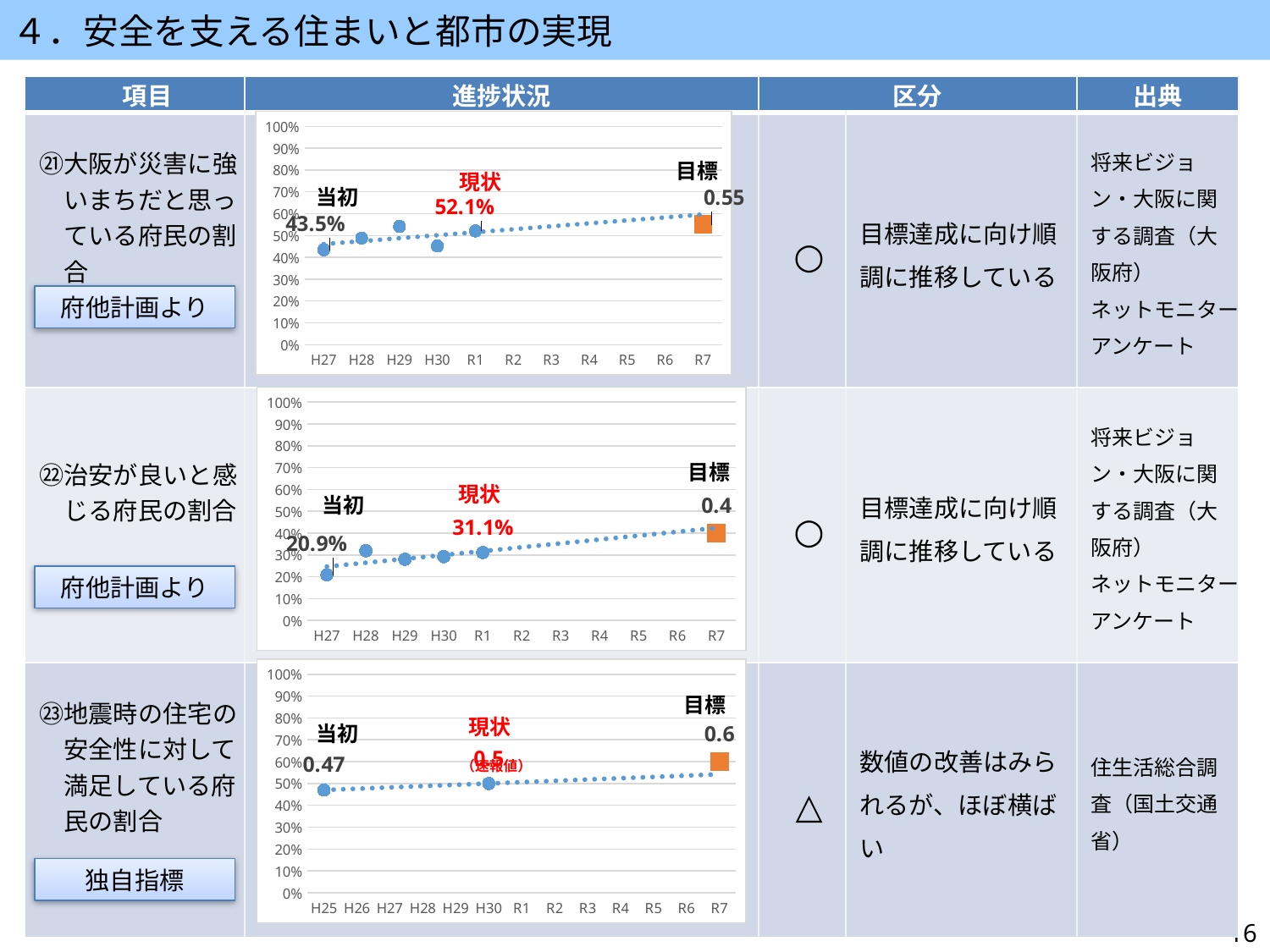
In the bottom chart (㉓地震時の住宅の安全性に対して満足している府民の割合), what is the 目標 (target) value? 0.6 In the middle chart (㉒治安が良いと感じる府民の割合), what is the 現状 (current) value? 31.1% In the top chart (㉑大阪が災害に強いまちだと思っている府民の割合), is the value for H30 greater or less than 50%? less How many year labels are shown on the x axis of the bottom chart (㉓地震時の住宅の安全性に対して満足している府民の割合)? 13 In the middle chart (㉒治安が良いと感じる府民の割合), do the plotted values rise or fall from H27 to R1? rise In the top chart (㉑大阪が災害に強いまちだと思っている府民の割合), what is the 当初 (initial) value? 43.5% In the middle chart (㉒治安が良いと感じる府民の割合), what is the 当初 (initial) value? 20.9% In the middle chart (㉒治安が良いと感じる府民の割合), is the value for H28 greater or less than 30%? greater In the top chart (㉑大阪が災害に強いまちだと思っている府民の割合), what is the 現状 (current) value? 52.1% In the top chart (㉑大阪が災害に強いまちだと思っている府民の割合), what is the 目標 (target) value shown at R7? 0.55 In the bottom chart (㉓地震時の住宅の安全性に対して満足している府民の割合), what is the 当初 (initial) value? 0.47 In the middle chart (㉒治安が良いと感じる府民の割合), what is the 目標 (target) value? 0.4